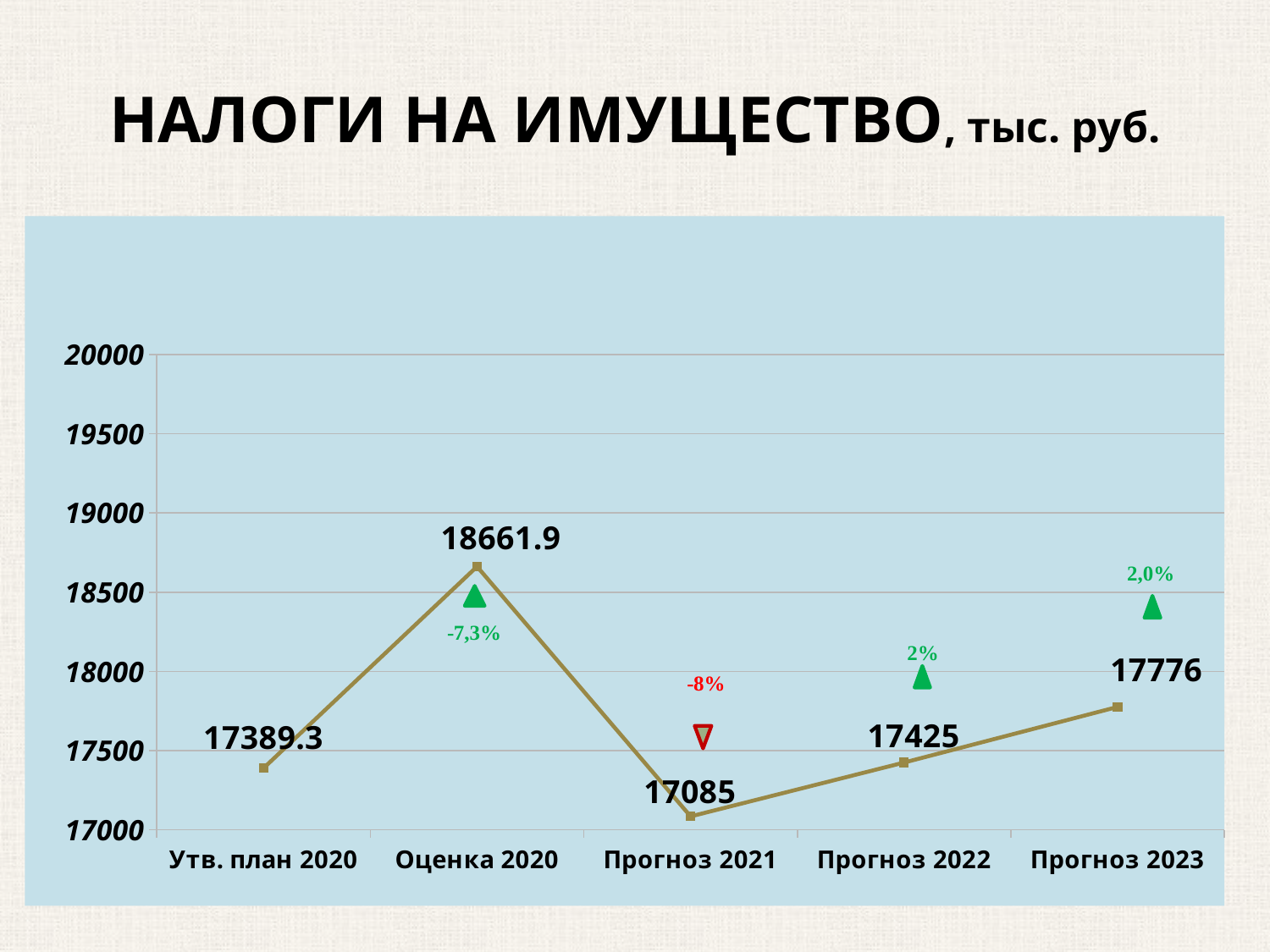
What is the value for Оценка 2020? 18661.9 What kind of chart is shown on the slide? Line chart What is the value for Прогноз 2023? 17776 What is the difference between the values for Прогноз 2023 and Прогноз 2022? 351 Which category has the lowest value? Прогноз 2021 What is the difference between the values for Оценка 2020 and Утв. план 2020? 1272.6 Which is larger, the value for Прогноз 2022 or the value for Утв. план 2020? Прогноз 2022 What is the value for Прогноз 2021? 17085 What is the value for Утв. план 2020? 17389.3 Which category has the highest value? Оценка 2020 Do the values rise or fall from Прогноз 2021 to Прогноз 2023? Rise How many categories are plotted on the x axis? 5